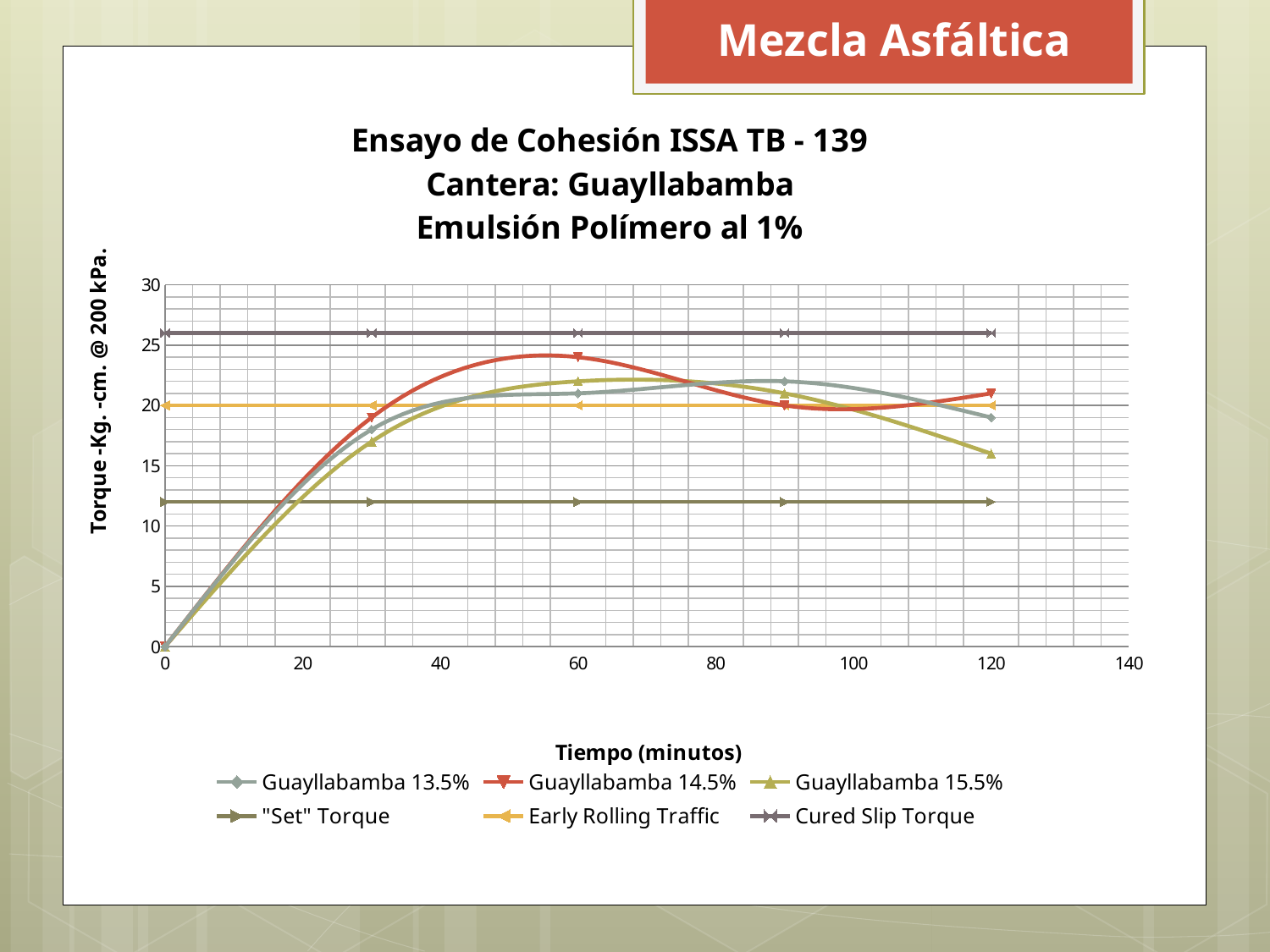
Among the three Guayllabamba series, which has the lowest value at 120 minutes? Guayllabamba 15.5% At 120 minutes, which is larger: Guayllabamba 14.5% or Guayllabamba 15.5%? Guayllabamba 14.5% What is the title of the x axis? Tiempo (minutos) What is the value of the Early Rolling Traffic line? 20 At 60 minutes, which is larger: Guayllabamba 14.5% or Guayllabamba 13.5%? Guayllabamba 14.5% Does the Guayllabamba 15.5% line rise or fall between 60 and 120 minutes? fall How many series does the legend list? 6 What kind of chart is shown on the slide? line chart Is the value of the "Set" Torque line greater or less than 15? less Is the value for Guayllabamba 14.5% at 60 minutes greater or less than 20? greater Is the value of the Cured Slip Torque line greater or less than 25? greater